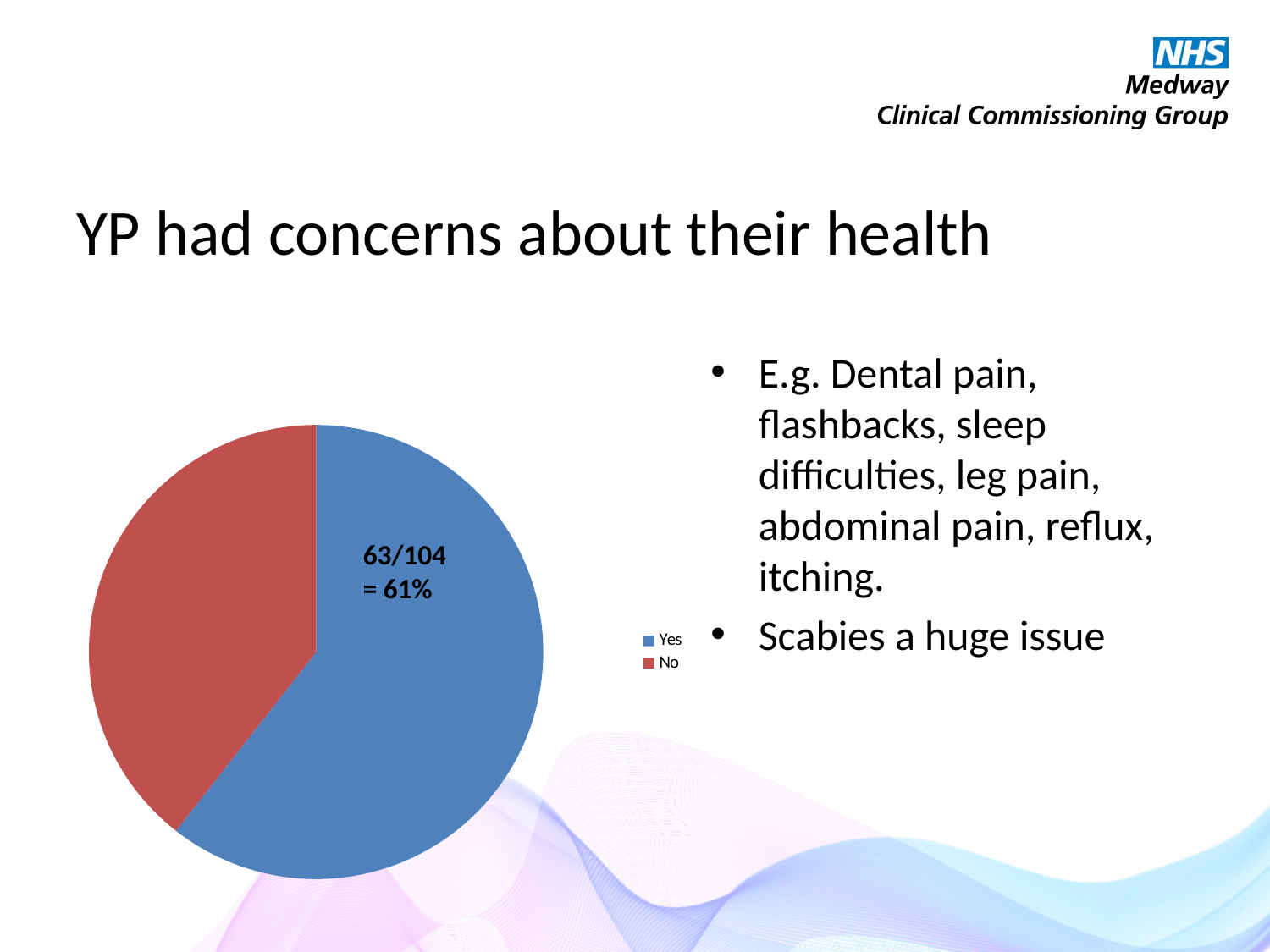
What colour is the No slice in the pie chart? Red What colour is the Yes slice in the pie chart? Blue How many entries does the pie chart's legend list? 2 How many slices does the pie chart have? 2 Which slice of the pie chart is the smallest? No Is the share of the Yes slice greater or less than 50%? greater What fraction is printed on the Yes slice of the pie chart? 63/104 Which is larger in the pie chart, the Yes slice or the No slice? Yes What kind of chart is shown on the slide? Pie chart What share of the pie does the Yes slice represent? 61% Which slice of the pie chart is the largest? Yes